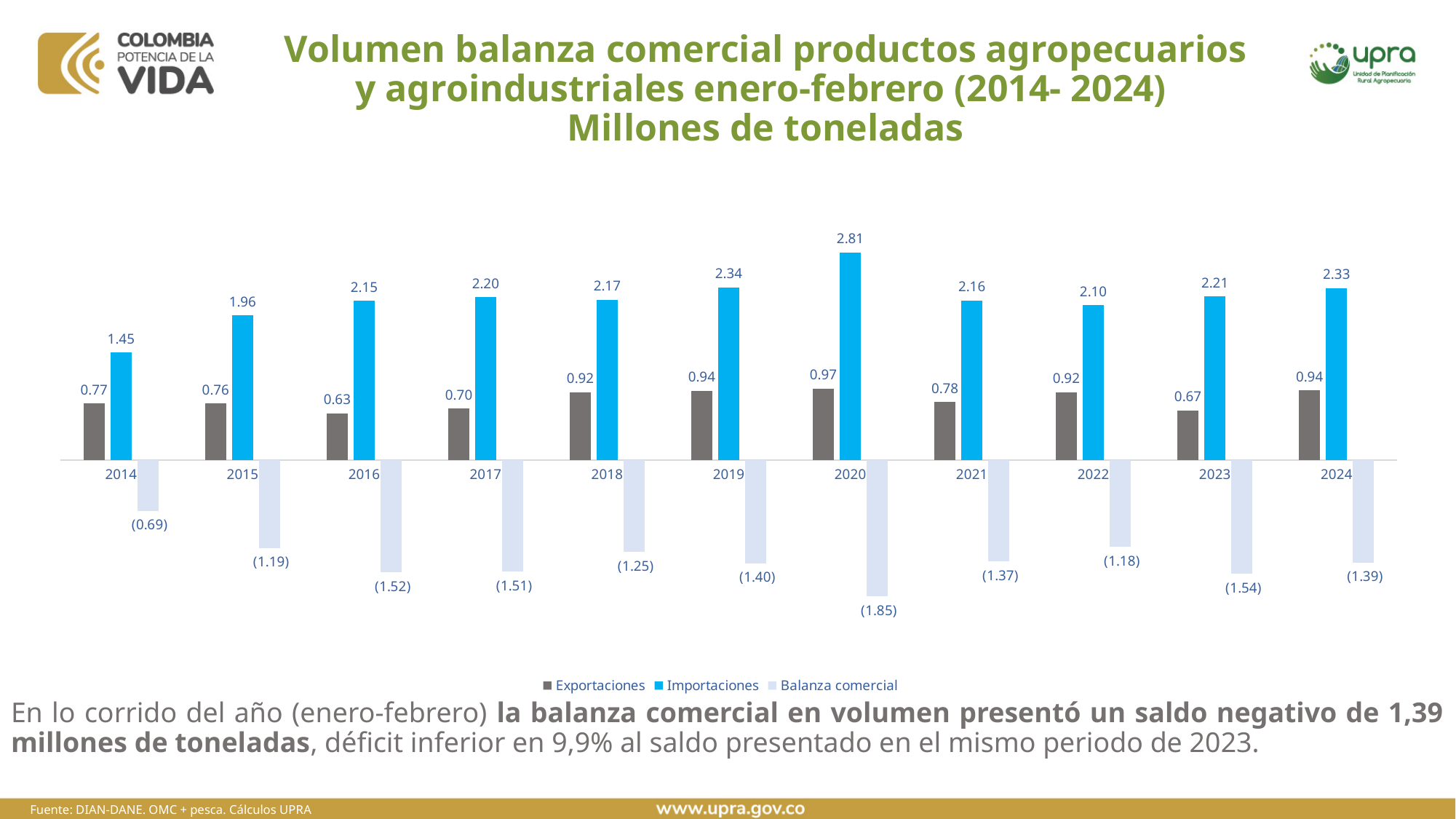
What is the Balanza comercial value for 2024? (1.39) What is the difference between Importaciones and Exportaciones in 2024? 1.39 Which year has the highest Importaciones value? 2020 What kind of chart is shown on the slide? Bar chart Which series is shown in light blue in the legend? Balanza comercial Which is larger, Exportaciones in 2018 or Exportaciones in 2023? Exportaciones in 2018 What is the value of Exportaciones in 2016? 0.63 Which year has the lowest Exportaciones value? 2016 How many years are shown on the x axis? 11 What is the value of Importaciones in 2020? 2.81 Did Importaciones rise or fall from 2014 to 2015? Rise How many series does the legend list? 3